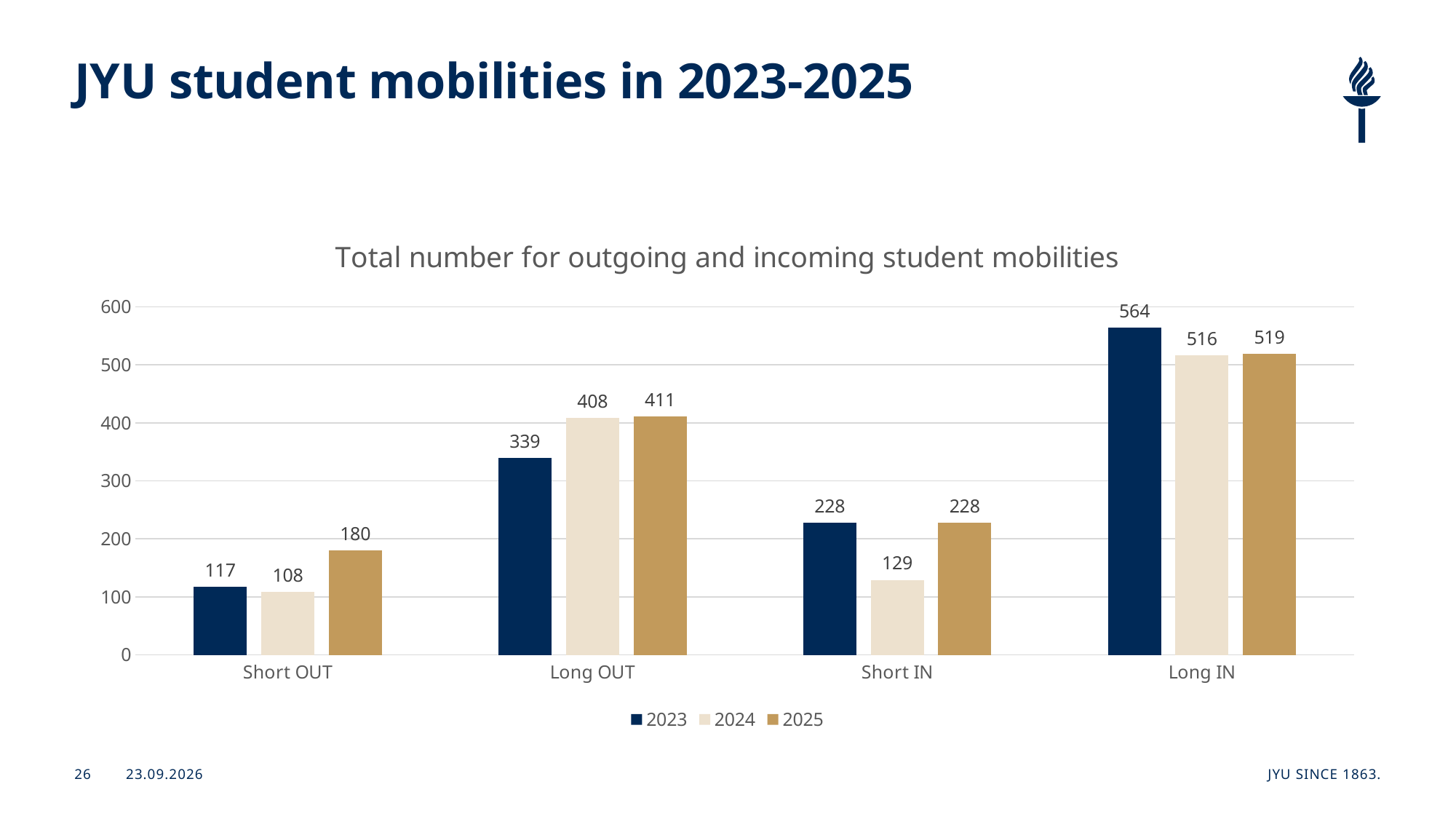
What is the title of the chart? Total number for outgoing and incoming student mobilities Is the 2023 value for Long OUT greater or less than 400? less How many categories are shown on the x axis? 4 Which is larger: the 2023 value for Short IN or the 2024 value for Short IN? 2023 What is the value for Short IN in 2025? 228 What is the difference between the 2025 and 2023 values for Short OUT? 63 Which category has the lowest value for the 2024 series? Short OUT How many series does the legend list? 3 Which category has the highest value for the 2025 series? Long IN What kind of chart is shown on the slide? bar chart What is the value for Long OUT in 2024? 408 What is the value for Long IN in 2023? 564